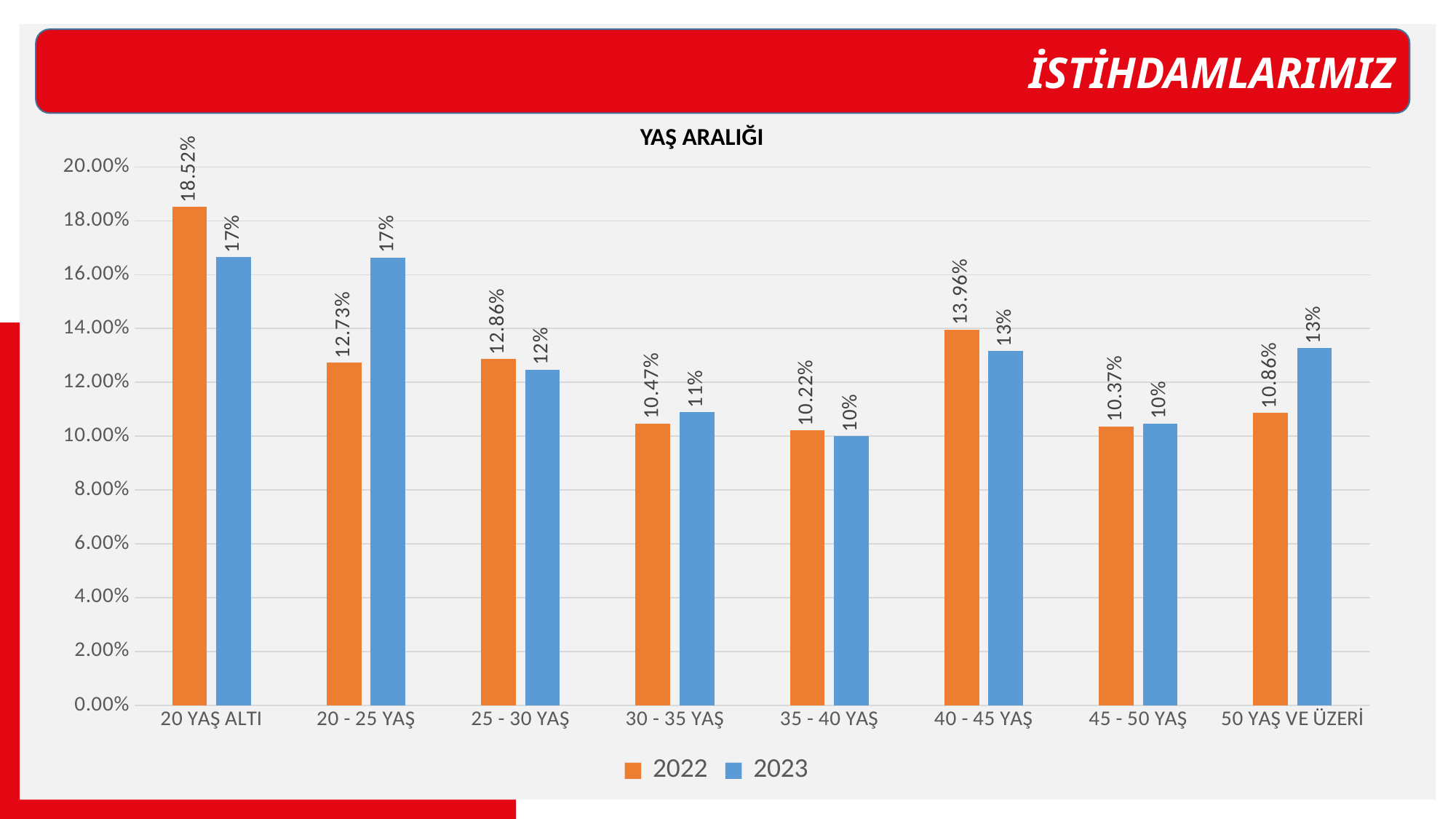
For 50 YAŞ VE ÜZERİ, which series has the larger value, 2022 or 2023? 2023 Which age group has the lowest 2022 value? 35 - 40 YAŞ How many age groups are shown on the x axis? 8 Is the 2022 value for 40 - 45 YAŞ greater or less than 12.00%? greater Which age group has the highest 2022 value? 20 YAŞ ALTI How many series does the legend list? 2 What is the 2023 value for 50 YAŞ VE ÜZERİ? 13% For 20 YAŞ ALTI, which series has the larger value, 2022 or 2023? 2022 What is the 2022 value for 40 - 45 YAŞ? 13.96% What is the 2022 value for 20 YAŞ ALTI? 18.52% What is the difference between the 2022 values for 20 YAŞ ALTI and 20 - 25 YAŞ? 5.79% What kind of chart is shown on the slide? bar chart